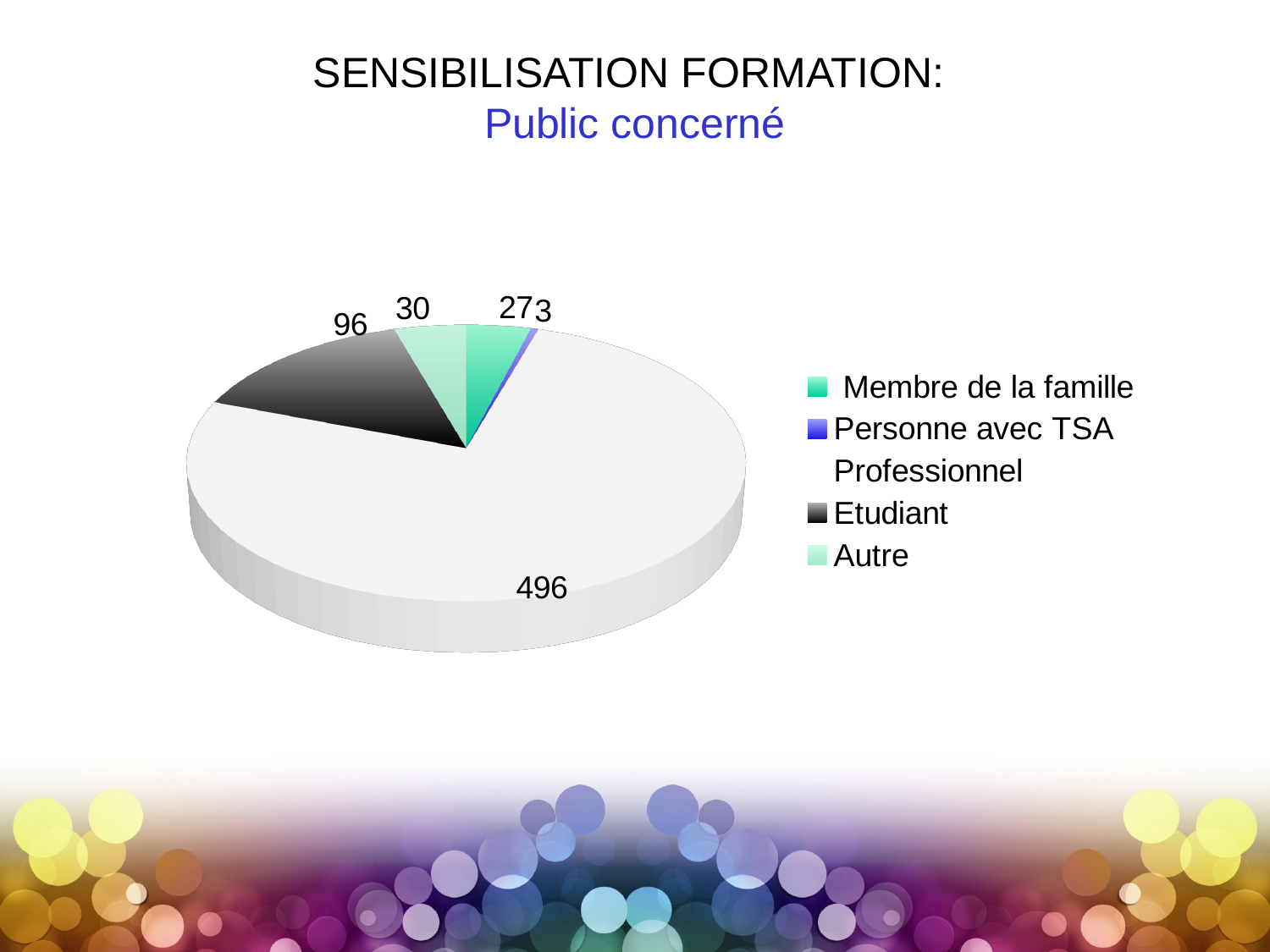
Which is larger, the value for Etudiant or the value for Autre? Etudiant What is the value for Autre? 30 What is the difference between the value for Etudiant and the value for Autre? 66 What is the value for Professionnel? 496 Which category has the smallest slice of the pie? Personne avec TSA What is the value for Etudiant? 96 What is the difference between the value for Professionnel and the value for Etudiant? 400 How many entries does the legend list? 5 How many categories does the pie chart have? 5 Which category has the largest slice of the pie? Professionnel What type of chart is shown on the slide? Pie chart What colour is the Etudiant slice? Black